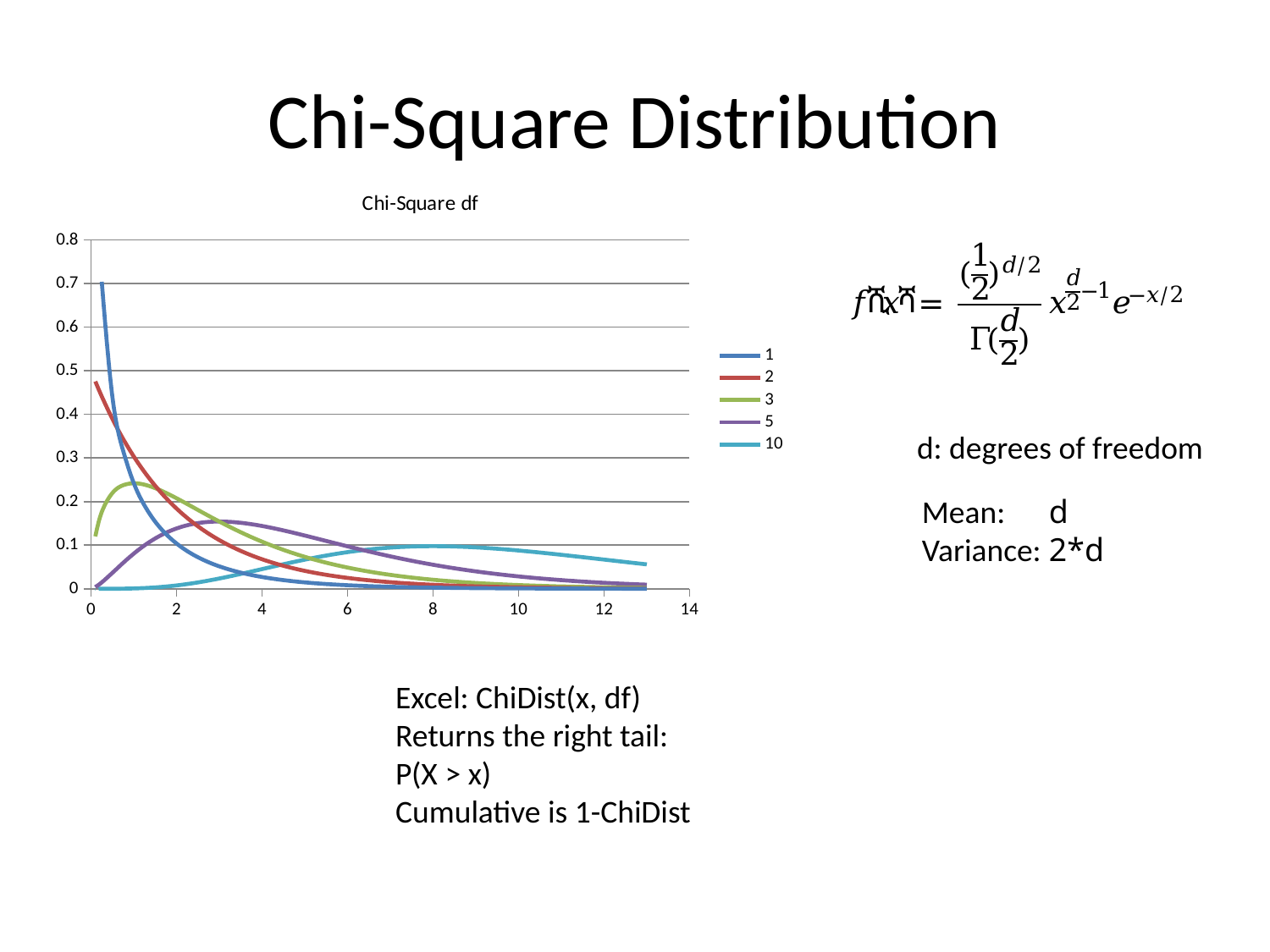
Which series has the lowest peak value on the chart? 10 Is the peak value of series 5 greater or less than 0.2? less How many series does the legend of the chart list? 5 Is the peak value of series 5 greater or less than 0.1? greater At x = 8, which is larger: series 1 or series 10? 10 Which series labels appear in the chart legend? 1, 2, 3, 5, 10 Does the value of series 1 rise or fall as x increases? falls Is the value of series 1 near x = 0 greater or less than 0.5? greater What is the title of the chart? Chi-Square df What kind of chart is shown on the slide? line chart Which series reaches the highest value on the chart? 1